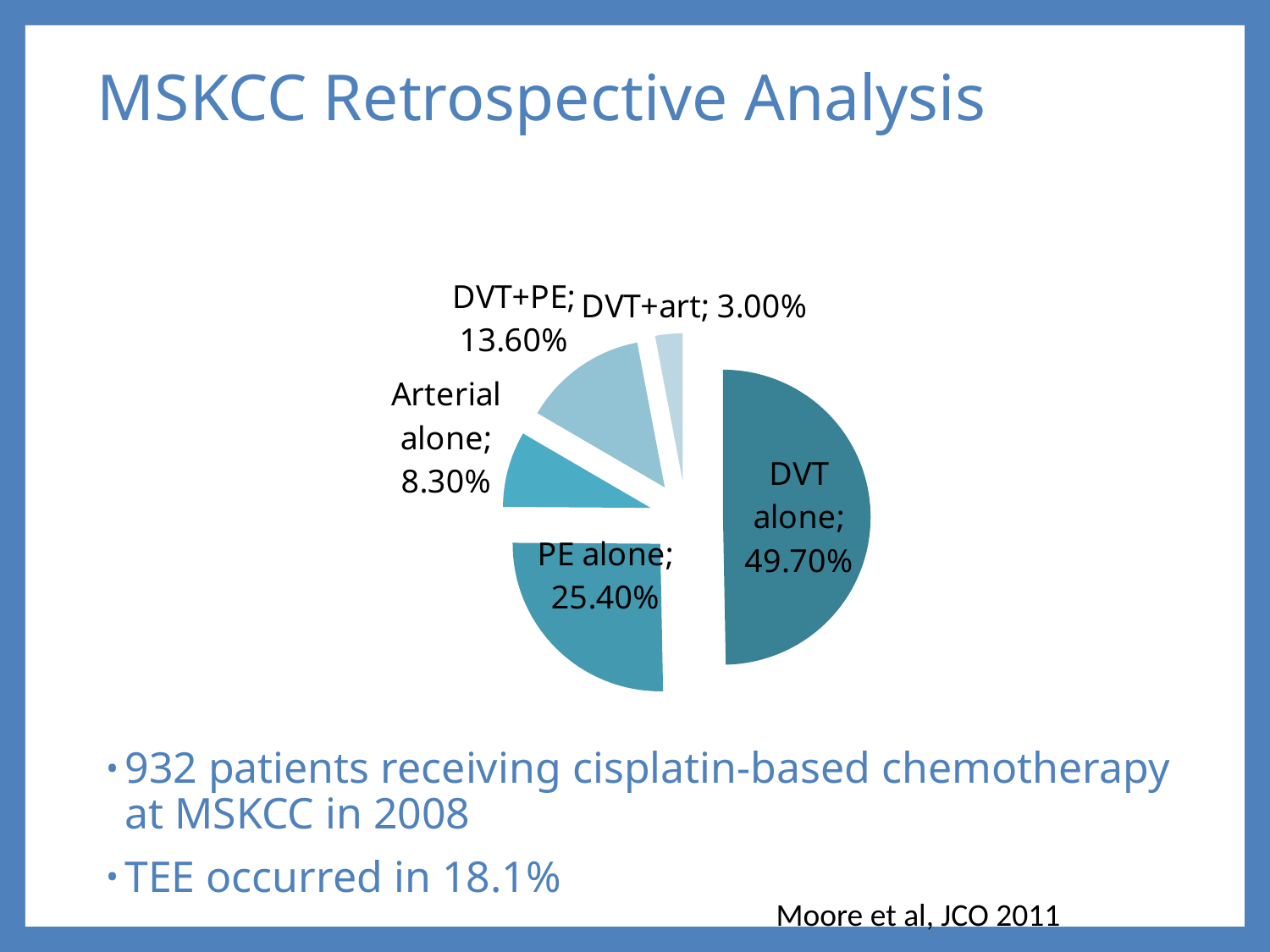
What is the value for PE alone? 25.40% What kind of chart is shown on the slide? pie chart Which is larger, DVT+PE or Arterial alone? DVT+PE How many slices does the pie chart have? 5 What is the value for Arterial alone? 8.30% What is the value for DVT alone? 49.70% What is the difference between the values for DVT alone and PE alone? 24.30% What is the difference between the values for DVT+PE and DVT+art? 10.60% What is the value for DVT+art? 3.00% Which category has the largest slice? DVT alone What is the value for DVT+PE? 13.60% Which category has the smallest slice? DVT+art